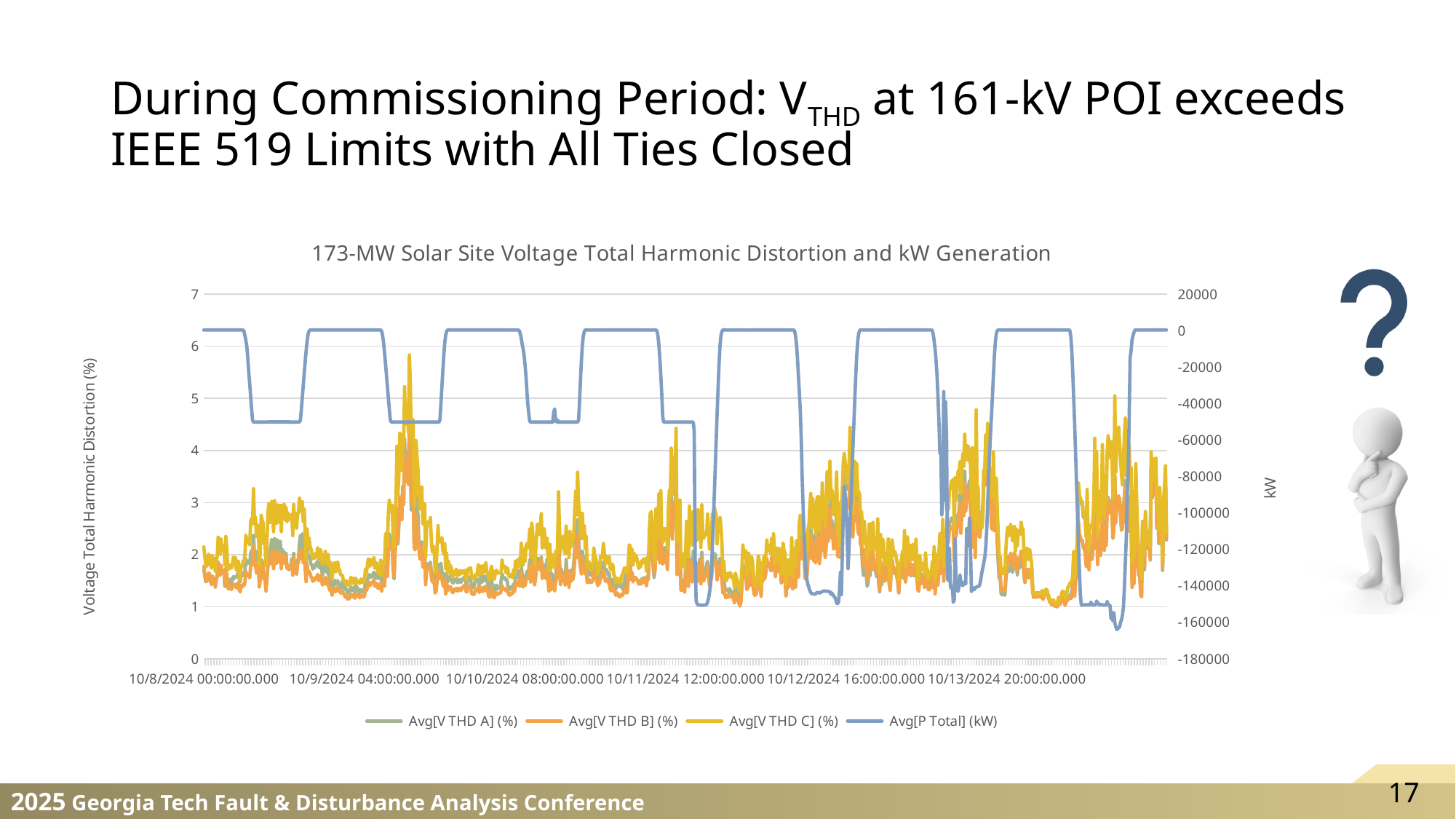
What is the highest tick value shown on the left axis? 7 Is the highest value reached by Avg[V THD C] (%) greater or less than 5? greater Is the highest value reached by Avg[V THD C] (%) greater or less than 6? less How many series does the legend list? 4 Which series is plotted against the right-hand kW axis? Avg[P Total] (kW) Is the lowest value reached by Avg[P Total] (kW) greater or less than -140000? less What is the lowest tick value shown on the right axis? -180000 What kind of chart is shown on the slide? line chart What value on the right axis does the upper plateau of Avg[P Total] (kW) sit at? 0 What is the title of the chart? 173-MW Solar Site Voltage Total Harmonic Distortion and kW Generation